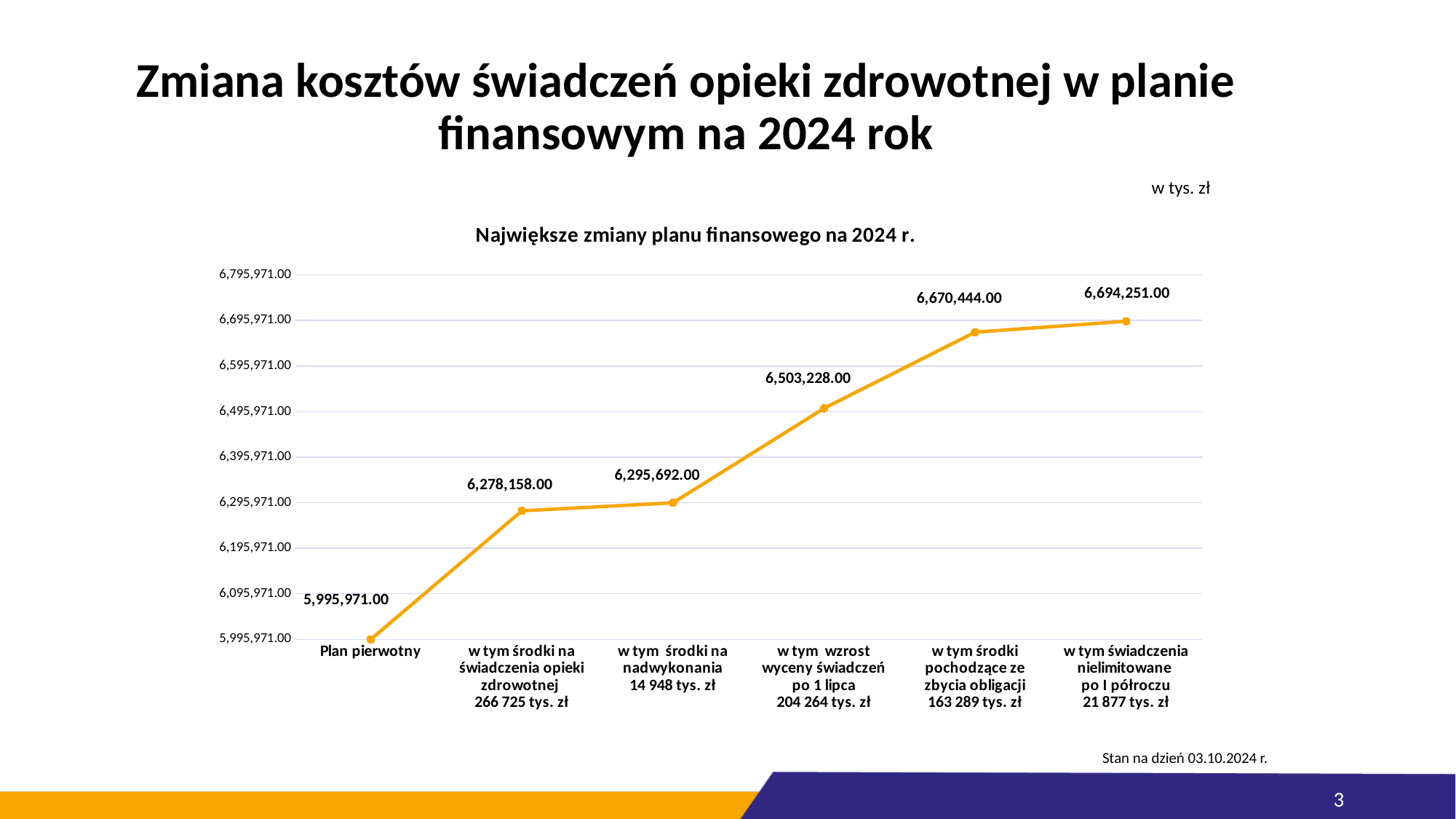
What is the difference between the value for "w tym świadczenia nielimitowane po I półroczu" and the value for "Plan pierwotny"? 698,280.00 Which category has the lowest value? Plan pierwotny How many data points are plotted on the chart? 6 Do the values rise or fall from left to right along the x axis? rise Which category has the highest value? w tym świadczenia nielimitowane po I półroczu What is the value for "w tym wzrost wyceny świadczeń po 1 lipca"? 6,503,228.00 What is the value for "w tym środki na nadwykonania"? 6,295,692.00 What is the value for "Plan pierwotny"? 5,995,971.00 What is the value for "w tym świadczenia nielimitowane po I półroczu"? 6,694,251.00 What kind of chart is shown on the slide? line chart Which is larger: the value for "w tym środki na świadczenia opieki zdrowotnej" or the value for "w tym wzrost wyceny świadczeń po 1 lipca"? w tym wzrost wyceny świadczeń po 1 lipca What is the difference between the value for "w tym środki pochodzące ze zbycia obligacji" and the value for "w tym wzrost wyceny świadczeń po 1 lipca"? 167,216.00